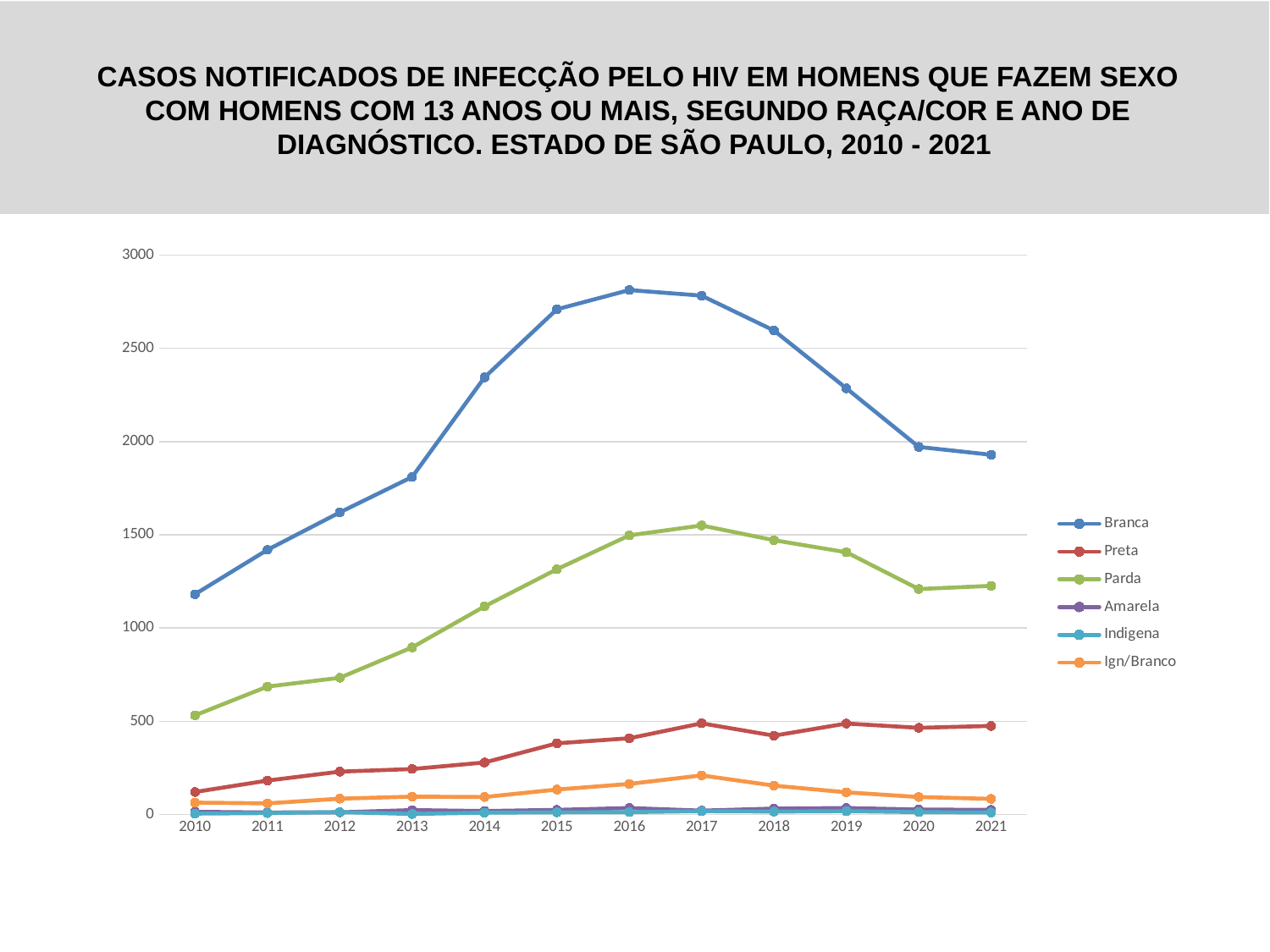
What kind of chart is shown on the slide? line chart Is the value for Branca in 2015 greater or less than 2500? greater Which is larger in 2016, the value for Parda or the value for Preta? Parda In which year is the Parda series at its lowest? 2010 Is the value for Branca in 2010 greater or less than 1000? greater In which year is the Branca series at its lowest? 2010 Which series has the highest value in 2016? Branca Does the Branca series rise or fall from 2017 to 2021? fall How many years are plotted along the x axis? 12 Which series is drawn in orange in the legend? Ign/Branco How many series does the legend list? 6 Is the value for Parda in 2013 greater or less than 1000? less